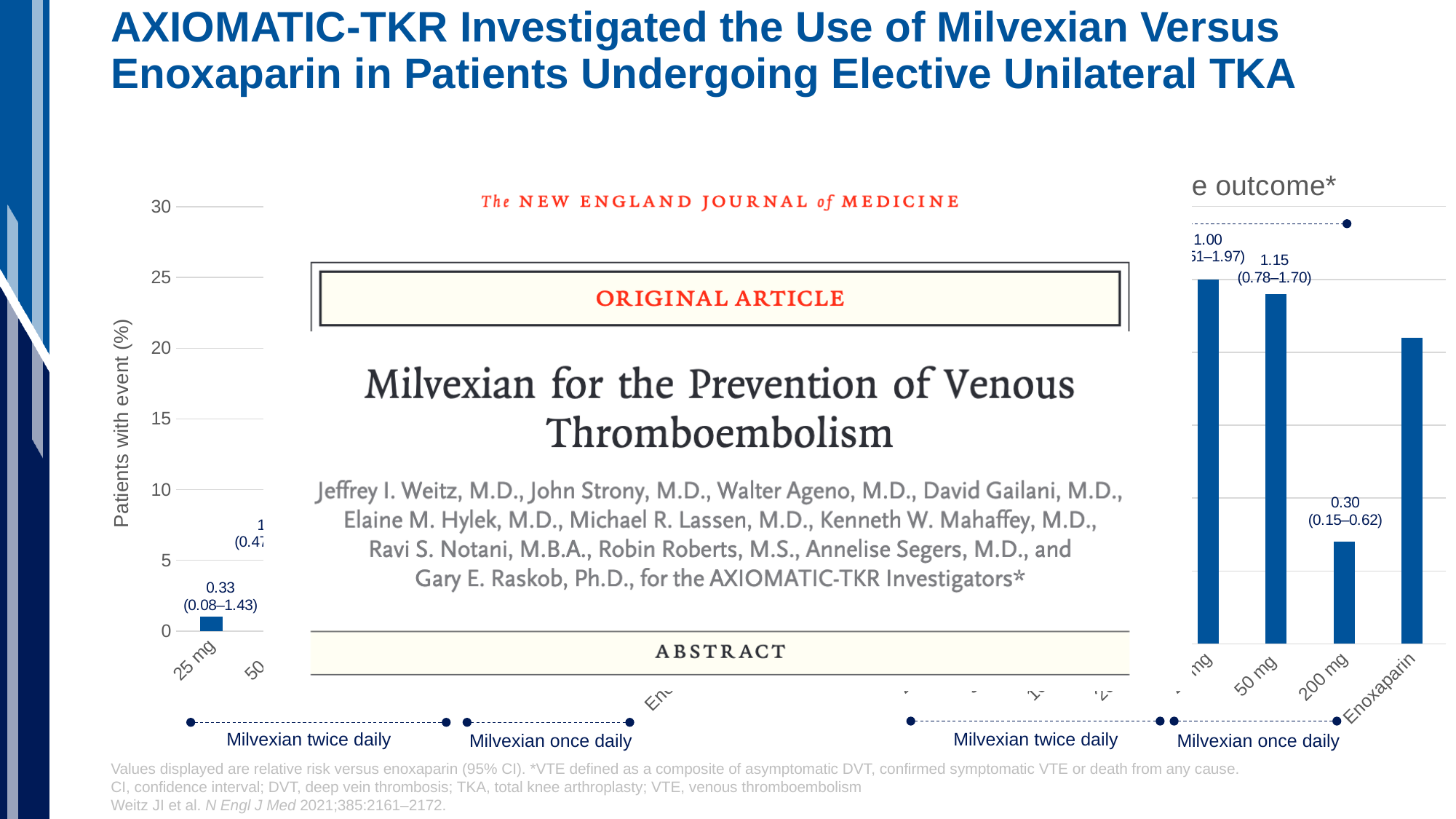
On the right chart, what 95% confidence interval is shown for the 50 mg once-daily bar? 0.78–1.70 On the right chart, what 95% confidence interval is shown for the 200 mg once-daily bar? 0.15–0.62 On the left chart, what 95% confidence interval is shown for the 25 mg bar? 0.08–1.43 On the right chart, which bar is taller: Enoxaparin or 200 mg once daily? Enoxaparin On the left chart, what is the y-axis title? Patients with event (%) On the right chart, which bar is taller: 50 mg once daily or 200 mg once daily? 50 mg What kind of chart is the left chart? bar chart On the left chart, is the value for the 25 mg bar greater or less than 5? less On the right chart, what is the difference between the relative risk labels for the 50 mg and 200 mg once-daily bars? 0.85 On the right chart, what relative risk value is labelled above the 200 mg once-daily bar? 0.30 On the right chart, what relative risk value is labelled above the 50 mg once-daily bar? 1.15 On the left chart, what relative risk value is labelled above the 25 mg bar? 0.33